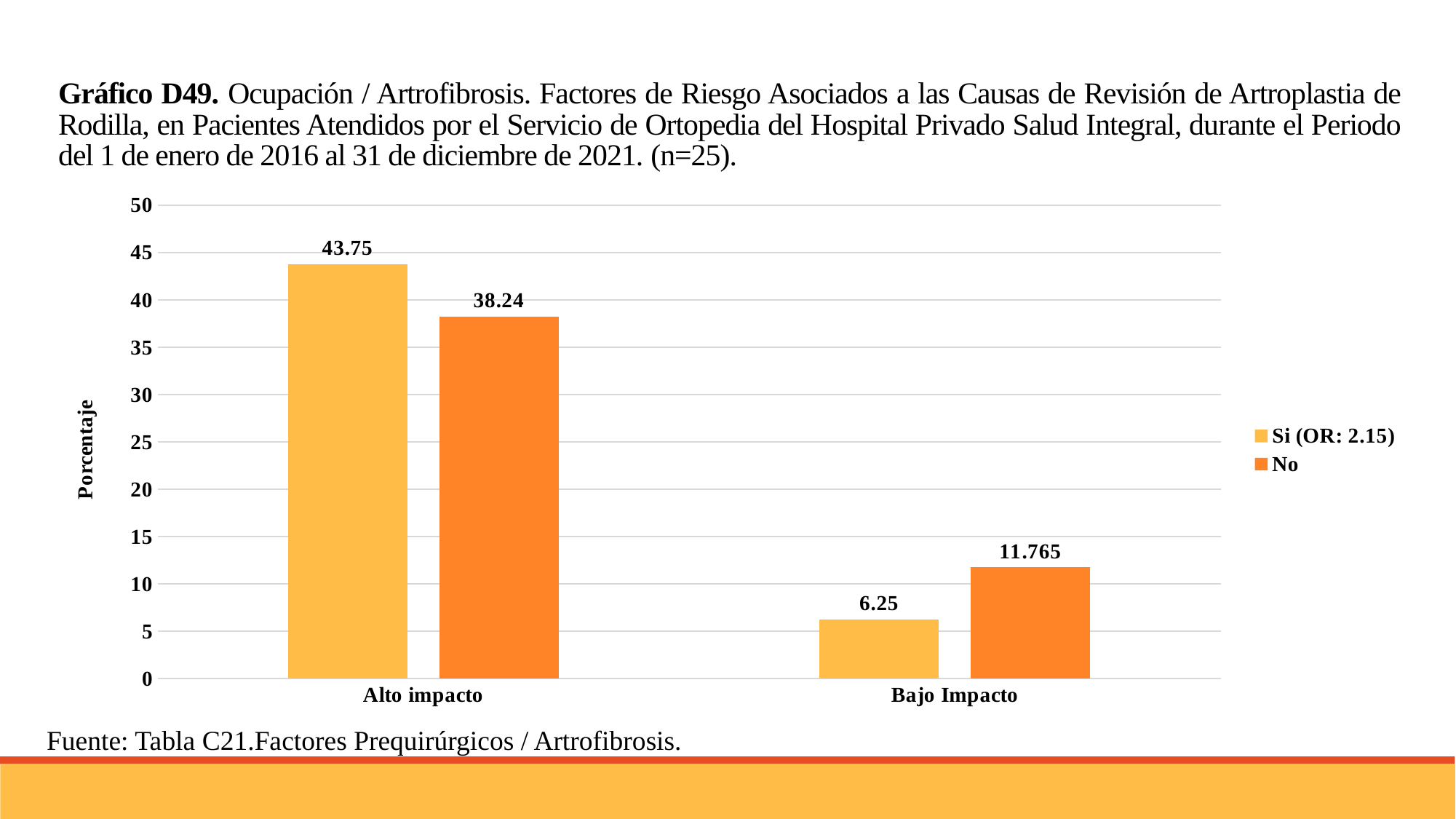
What is the difference between the 'Si (OR: 2.15)' and 'No' values in the 'Alto impacto' category? 5.51 What is the value for 'No' in the 'Alto impacto' category? 38.24 Which bar has the highest value on the chart? Si (OR: 2.15) in Alto impacto How many categories are shown on the x axis? 2 What is the value for 'Si (OR: 2.15)' in the 'Alto impacto' category? 43.75 What is the value for 'No' in the 'Bajo Impacto' category? 11.765 In the 'Bajo Impacto' category, which series has the larger value, 'Si (OR: 2.15)' or 'No'? No Which bar has the lowest value on the chart? Si (OR: 2.15) in Bajo Impacto What is the value for 'Si (OR: 2.15)' in the 'Bajo Impacto' category? 6.25 What is the label of the vertical axis? Porcentaje How many series does the legend list? 2 What kind of chart is shown on the slide? Bar chart